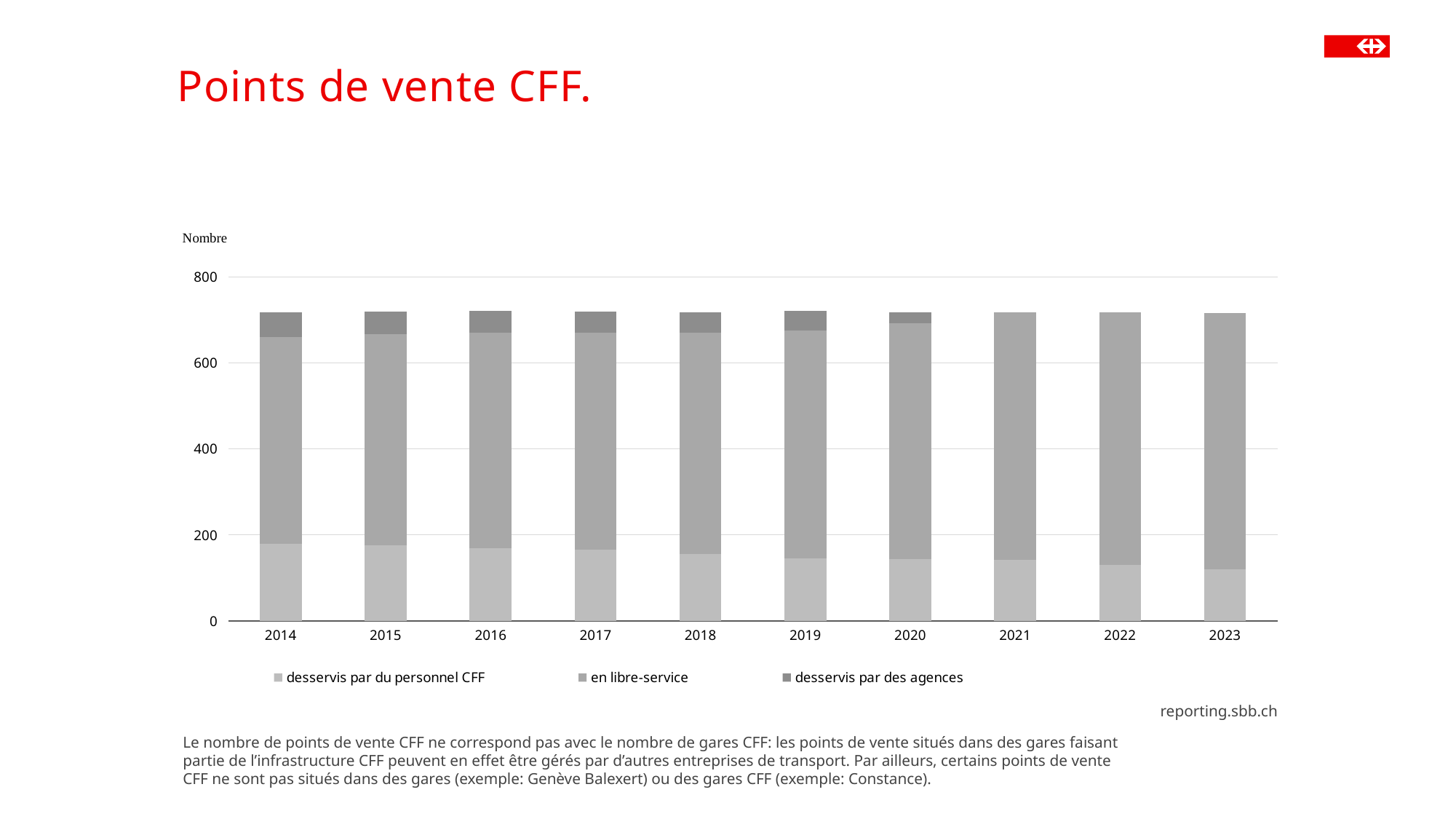
Is the value for 'desservis par du personnel CFF' in 2014 greater or less than 100? greater Is the total height of the stacked bar for 2023 greater or less than 800? less What is the title of the slide containing the chart? Points de vente CFF. How many years are shown on the x axis of the chart? 10 Does the 'desservis par du personnel CFF' segment rise or fall from 2014 to 2023? fall What label is shown on the vertical axis of the chart? Nombre Is the value for 'desservis par du personnel CFF' in 2023 greater or less than 200? less How many series does the chart legend list? 3 Which series has the largest segment in the 2014 bar? en libre-service Is the 'desservis par du personnel CFF' segment larger in 2014 or in 2023? 2014 What kind of chart is shown on the slide? stacked bar chart